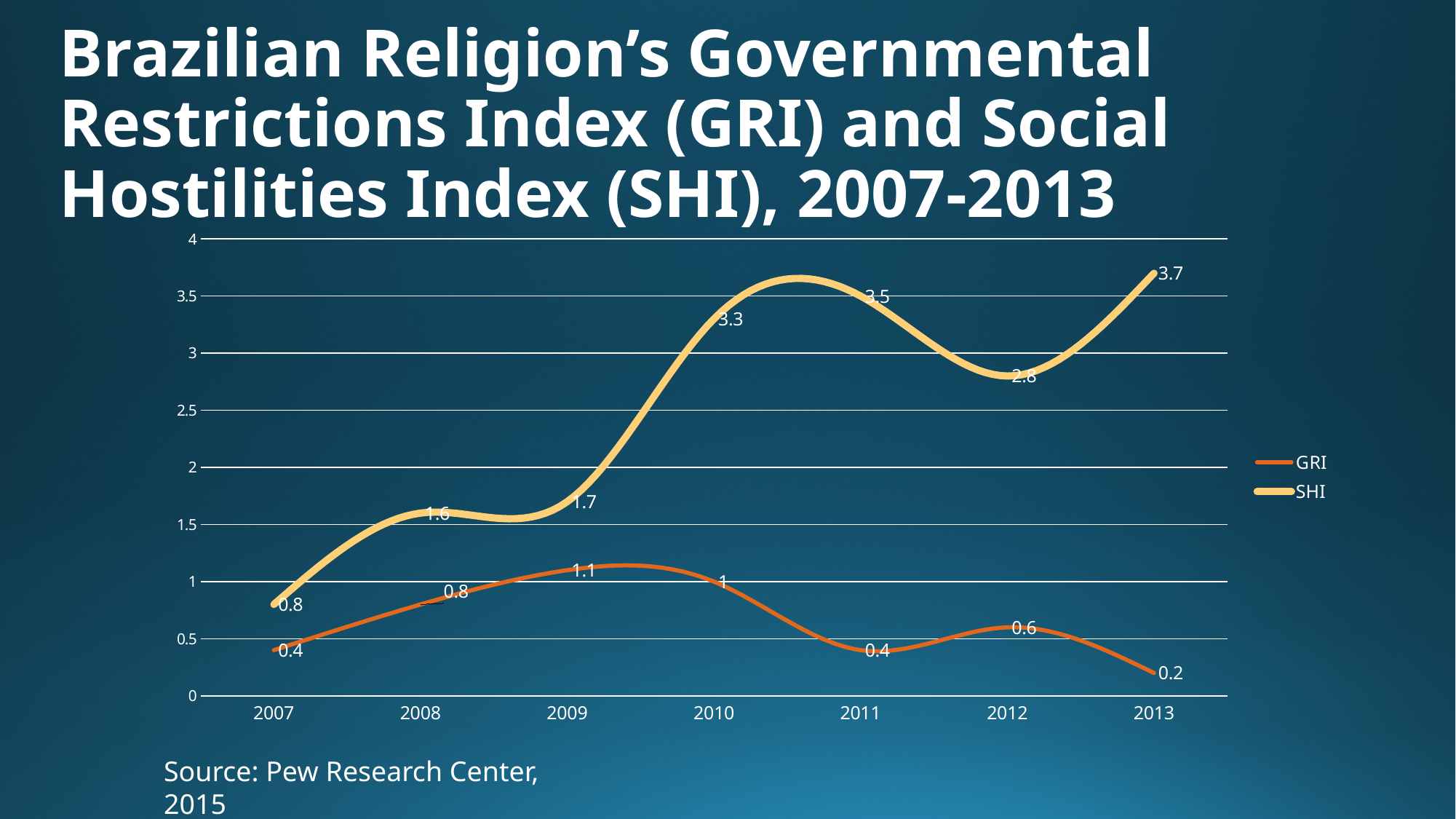
What is the GRI value for 2013? 0.2 How many series does the legend list? 2 What kind of chart is shown on the slide? line chart What is the SHI value for 2013? 3.7 Which is larger in 2012, the SHI value or the GRI value? SHI What is the SHI value for 2007? 0.8 In which year is the SHI value highest? 2013 What is the difference between the SHI and GRI values in 2010? 2.3 Is the SHI value for 2011 greater or less than 3? greater What is the GRI value for 2009? 1.1 How many years are plotted on the x axis? 7 In which year is the GRI value lowest? 2013